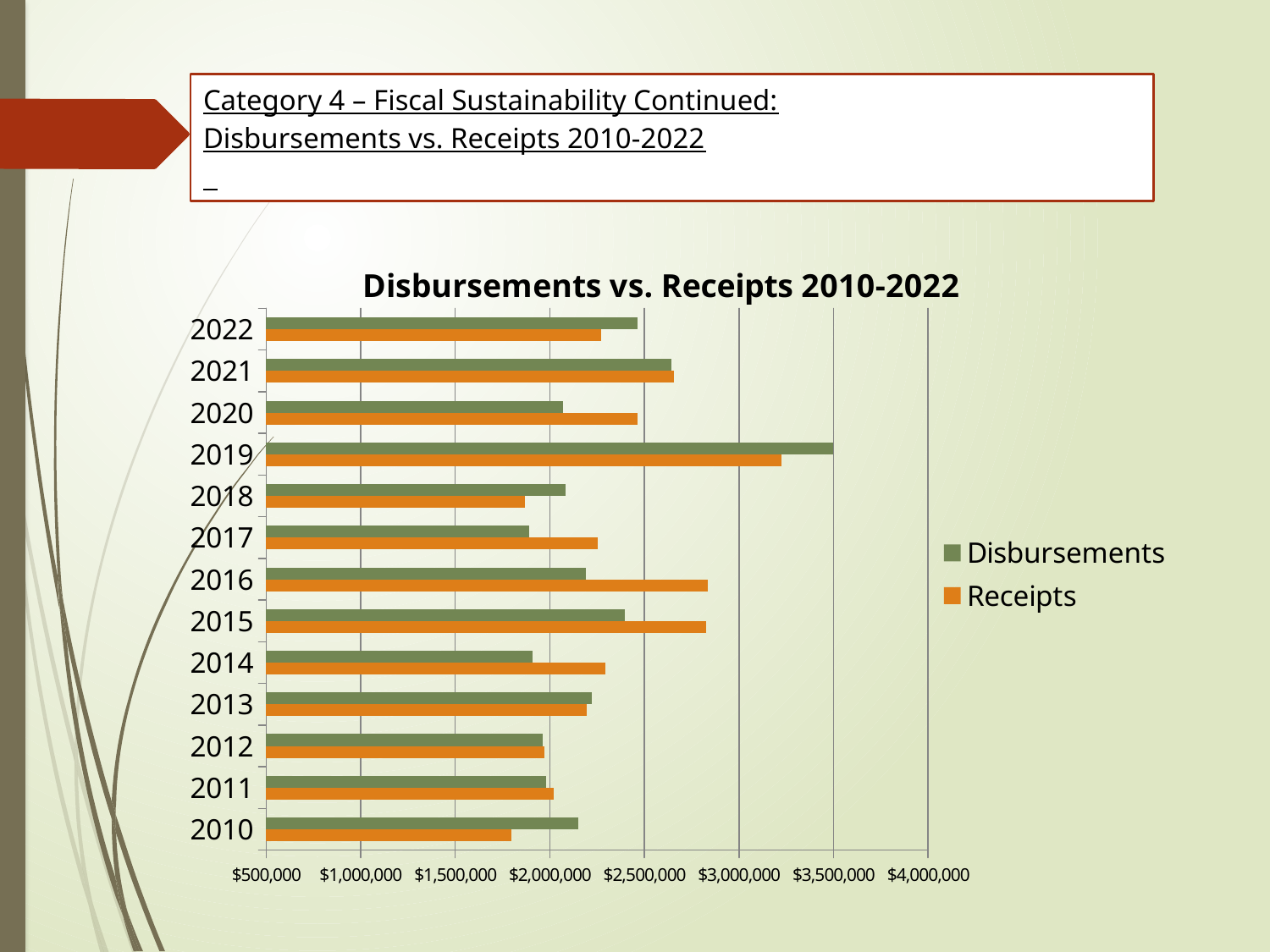
Is the Receipts value for 2016 greater or less than $2,500,000? greater Is the Disbursements value for 2020 greater or less than $2,500,000? less What kind of chart is shown on the slide? Bar chart What is the title of the chart? Disbursements vs. Receipts 2010-2022 How many years are shown on the chart? 13 Is the Disbursements value for 2019 greater or less than $3,000,000? greater In 2010, which is larger, Disbursements or Receipts? Disbursements In 2016, which is larger, Disbursements or Receipts? Receipts Which year has the highest Receipts value? 2019 How many series does the legend list? 2 Which year has the highest Disbursements value? 2019